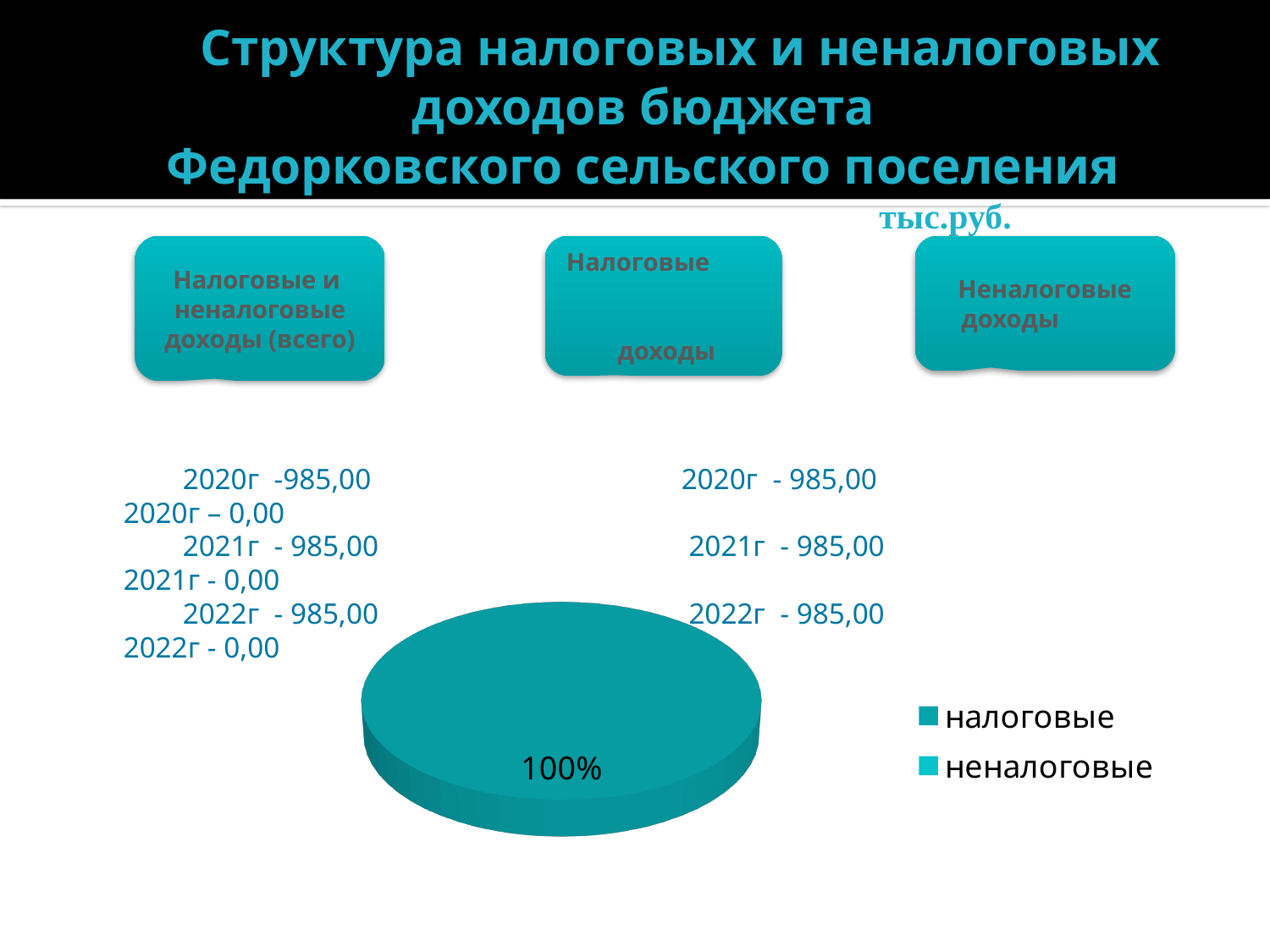
What is the value of Налоговые доходы for 2022г shown on the slide? 985,00 What share of the pie does the category неналоговые take, according to the slide? 0% What kind of chart is shown on the slide? pie chart What is the value of Налоговые и неналоговые доходы (всего) for 2020г shown on the slide? 985,00 How many entries does the legend of the pie chart list? 2 What are the two legend entries of the pie chart? налоговые, неналоговые Which category makes up the whole pie chart? налоговые What is the value of Неналоговые доходы for 2021г shown on the slide? 0,00 What share of the pie chart is labelled with a data label? 100% Which is larger in the pie chart, налоговые or неналоговые? налоговые In what units are the values on the slide given? тыс.руб. Is the share of налоговые in the pie chart greater or less than 50%? greater